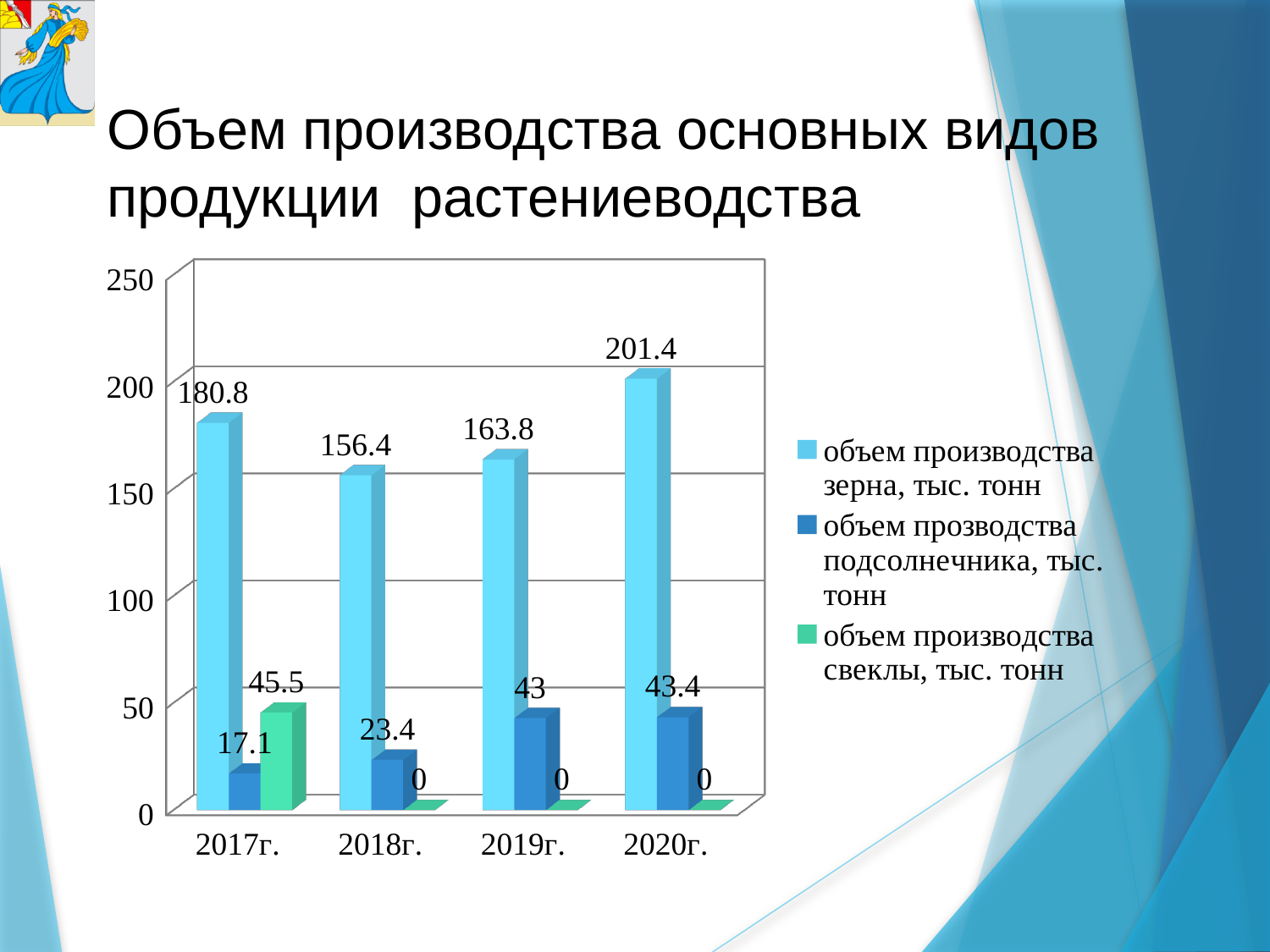
What kind of chart is shown on the slide? bar chart Which is larger: sunflower production in 2019г. or beet production in 2017г.? beet production in 2017г. In which year is grain production the highest? 2020г. What is the volume of grain production (объем производства зерна) in 2020г.? 201.4 What is the volume of beet production (объем производства свеклы) in 2017г.? 45.5 In which year is grain production the lowest? 2018г. What is the volume of sunflower production (объем прозводства подсолнечника) in 2018г.? 23.4 Does sunflower production rise or fall from 2017г. to 2020г.? rise How many series does the legend list? 3 What is the difference between grain production in 2020г. and 2017г.? 20.6 How many years are shown on the x axis? 4 Is grain production in 2019г. greater or less than 150? greater